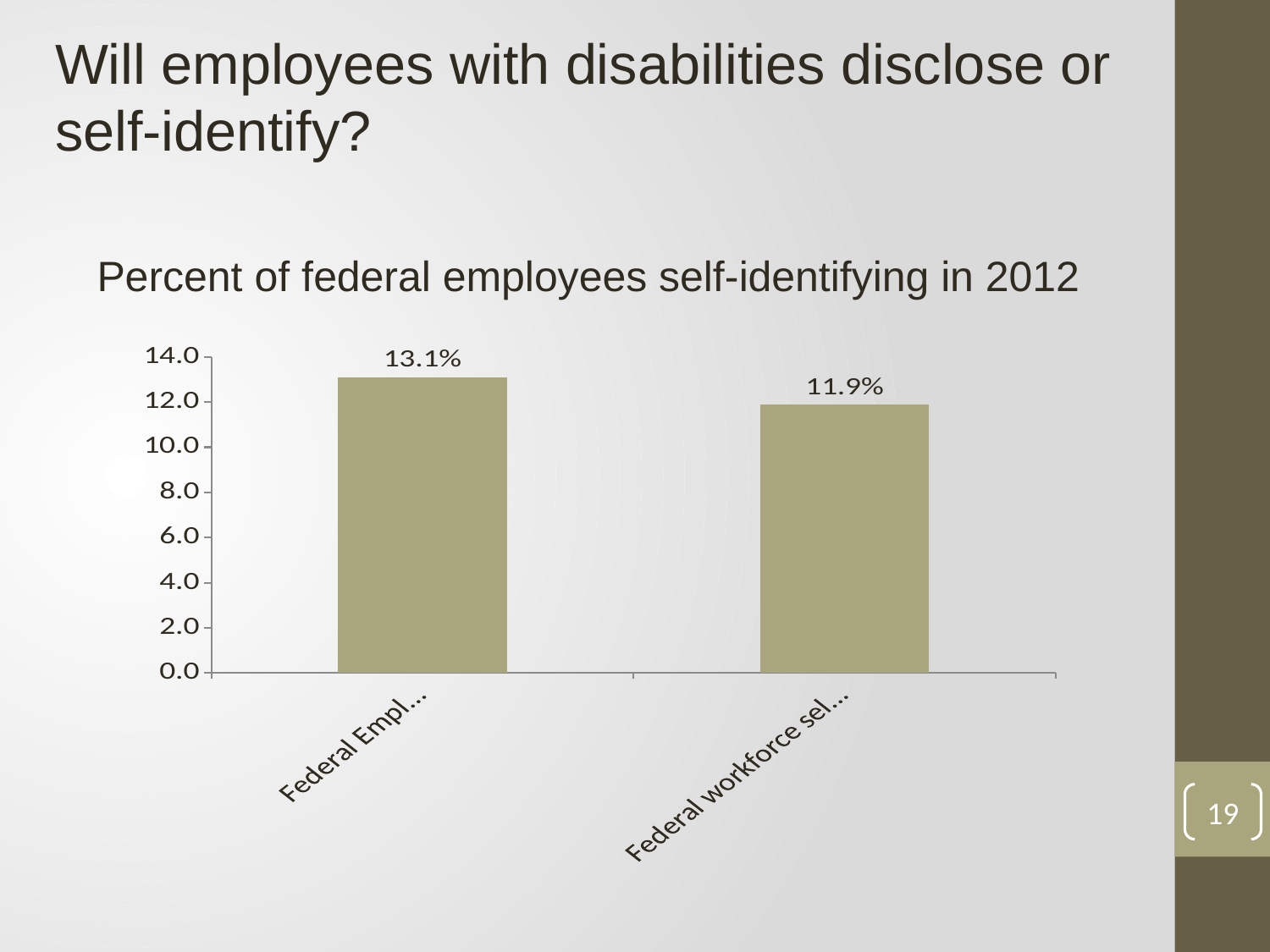
What is the difference between the left bar's value and the right bar's value? 1.2 percentage points Is the value for the left bar greater or less than 12.0? greater Which bar has the higher value, the left bar or the right bar? The left bar What is the value shown for the right bar in the chart? 11.9% What type of chart is shown on the slide? Bar chart Which bar has the lower value, the left bar or the right bar? The right bar What is the value shown for the left bar in the chart? 13.1% How many bars are plotted in the chart? 2 What is the highest value shown on the vertical axis of the chart? 14.0 What is the title of the chart? Percent of federal employees self-identifying in 2012 Is the value for the right bar greater or less than 10.0? greater Is the value of the left bar larger or smaller than the value of the right bar? Larger